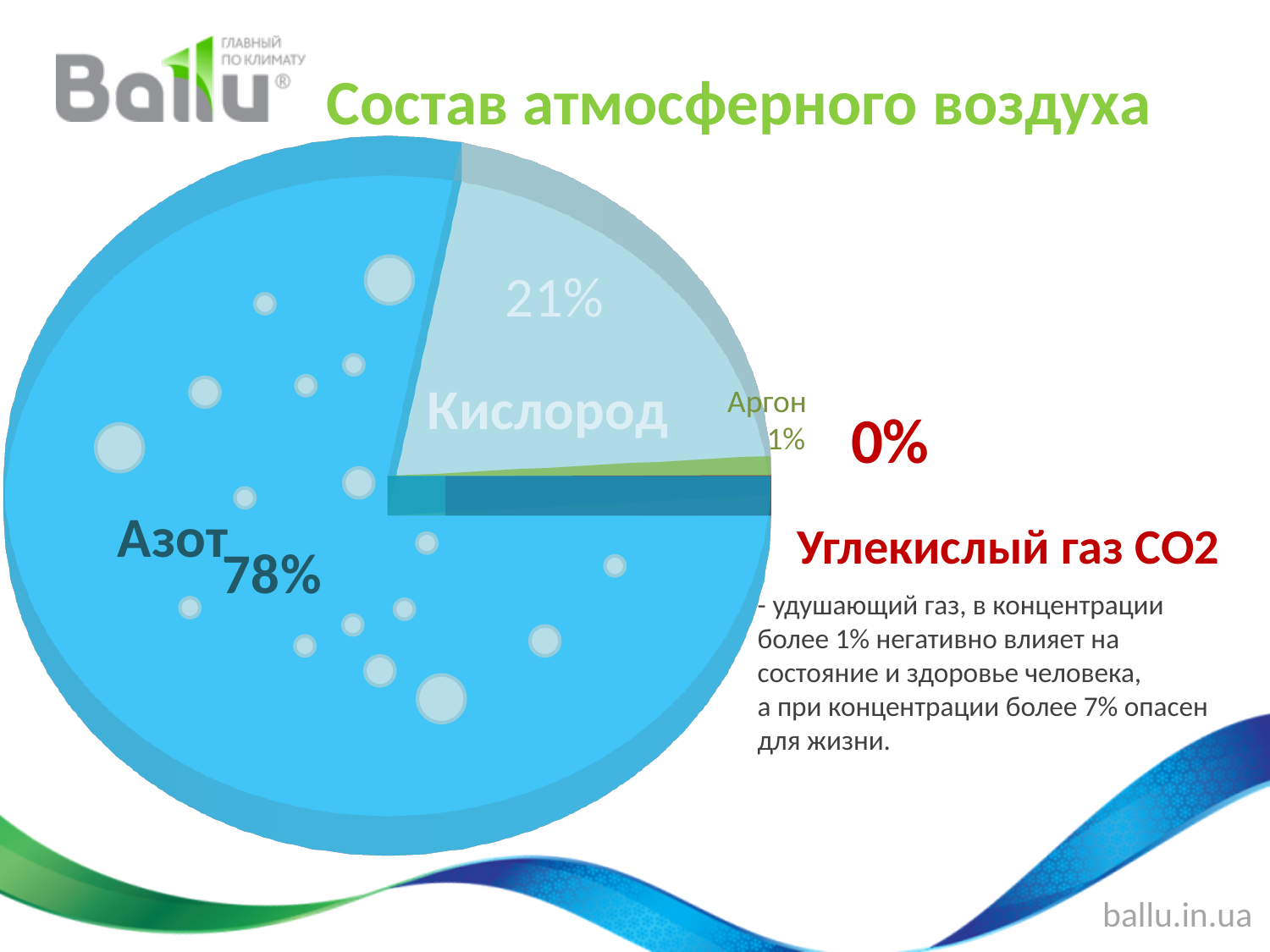
By how many percentage points does the share of Азот exceed the share of Кислород? 57 percentage points How many gases are labeled with a percentage on the chart? 4 What colour is the Азот slice of the pie? blue What is the title of the slide's chart? Состав атмосферного воздуха What share of atmospheric air is Азот according to the chart? 78% What percentage is shown for Углекислый газ CO2? 0% What share of atmospheric air is Аргон according to the chart? 1% Which gas has the largest slice of the pie? Азот What type of chart is shown on the slide? pie chart Which labeled gas has the smallest share in the chart? Углекислый газ CO2 Which is larger, the share of Кислород or the share of Аргон? Кислород What share of atmospheric air is Кислород according to the chart? 21%